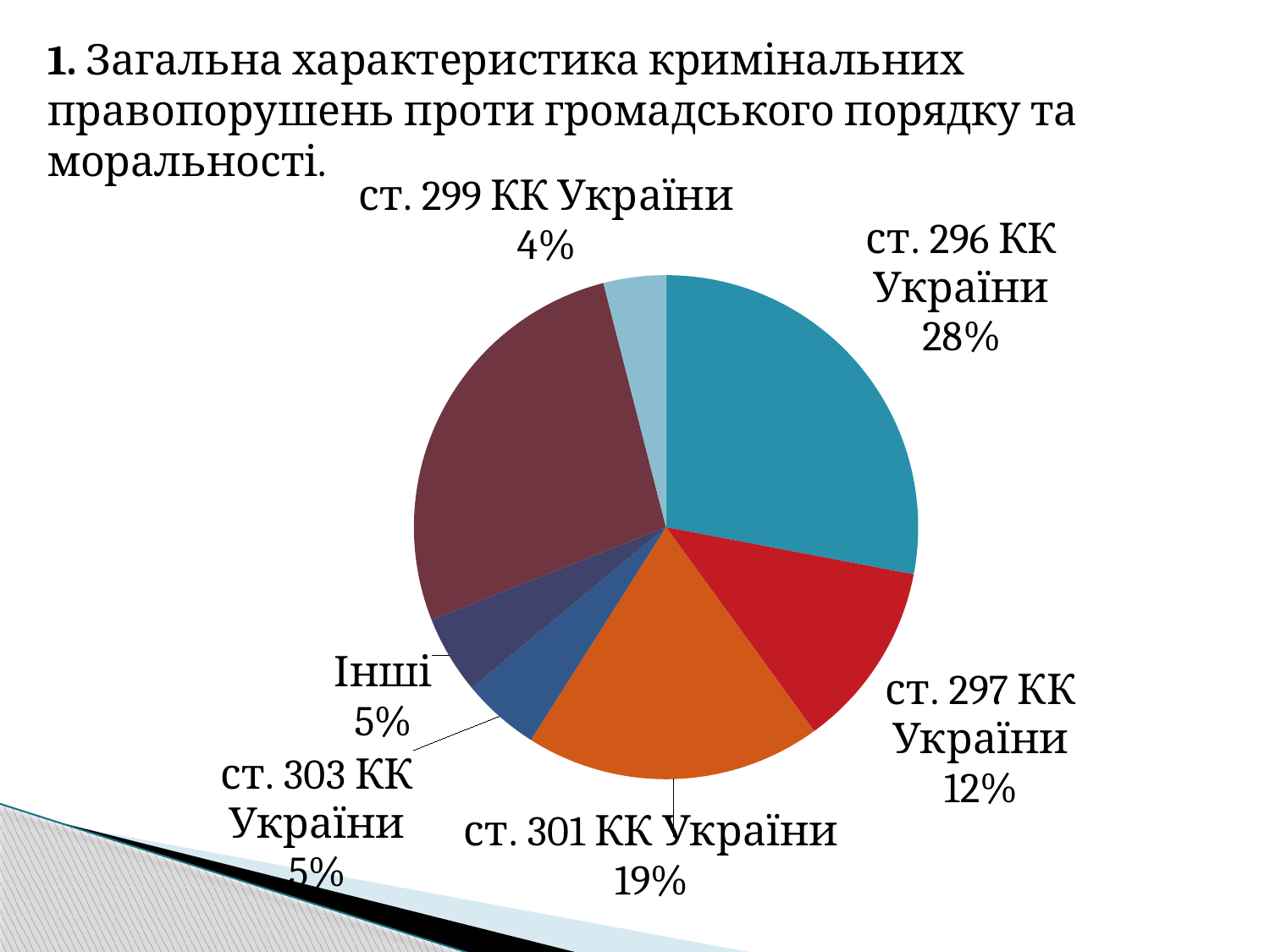
What share of the pie does the slice labelled Інші have? 5% How many slices does the pie chart have? 7 What share of the pie does ст. 301 КК України have? 19% What share of the pie does ст. 303 КК України have? 5% What kind of chart is shown on the slide? pie chart What share of the pie does ст. 296 КК України have? 28% What share of the pie does ст. 297 КК України have? 12% What colour is the slice for ст. 296 КК України? teal blue What is the difference in percentage points between the shares for ст. 296 КК України and ст. 297 КК України? 16 percentage points Which is larger, the share for ст. 301 КК України or the share for ст. 297 КК України? ст. 301 КК України What share of the pie does ст. 299 КК України have? 4% Which is larger, the share for ст. 296 КК України or the share for ст. 301 КК України? ст. 296 КК України